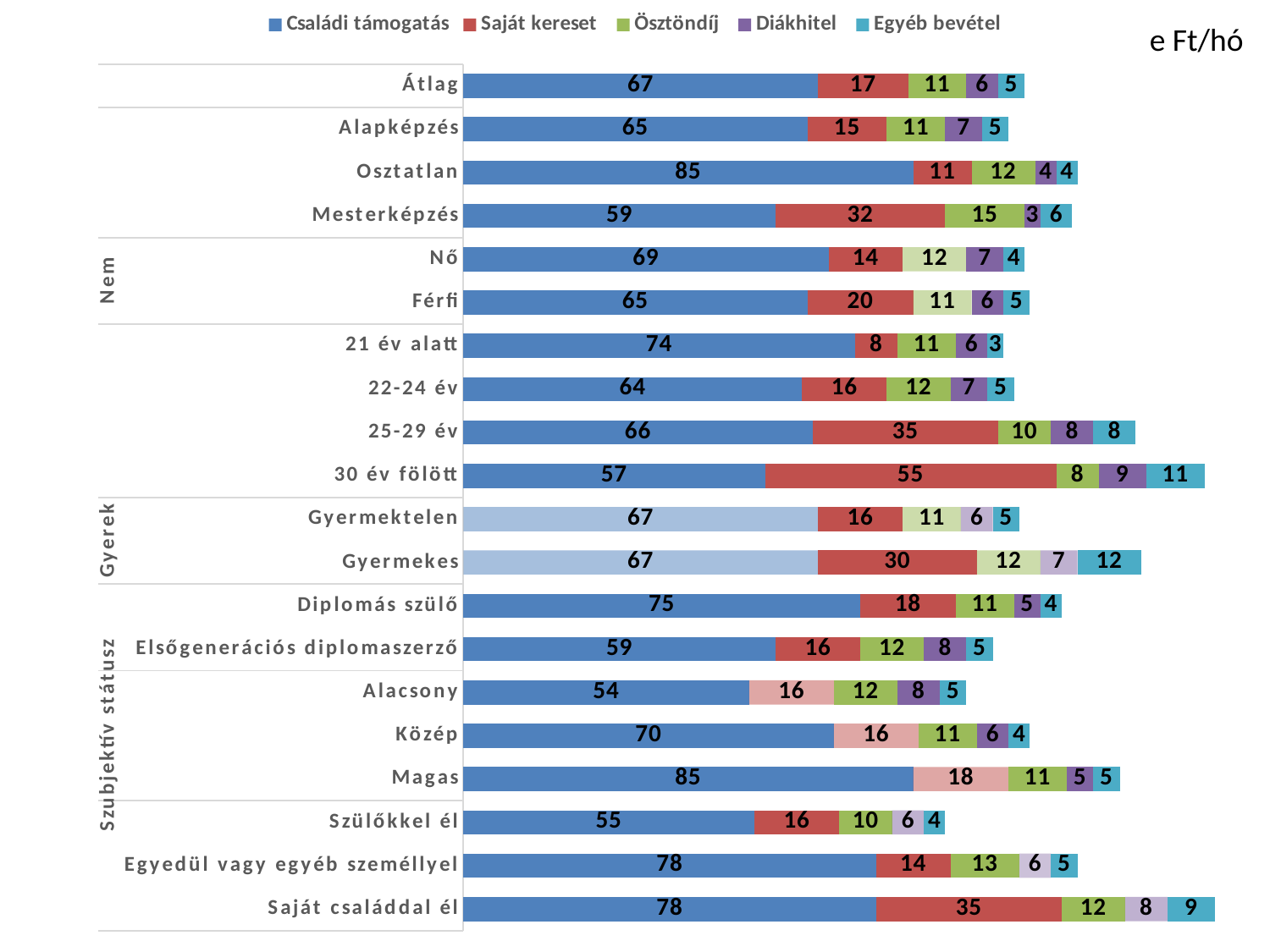
What is the total of the stacked bar for Átlag? 106 Which category has the lowest Családi támogatás value? Alacsony What is the difference between the Családi támogatás values for Osztatlan and Alapképzés? 20 What unit is shown in the top-right corner of the chart? e Ft/hó Which is larger, the Saját kereset value for 25-29 év or for 22-24 év? 25-29 év How many categories (bars) are plotted in the chart? 20 How many series does the legend list? 5 What is the Saját kereset value for 30 év fölött? 55 Which category has the highest Saját kereset value? 30 év fölött What is the Családi támogatás value for Mesterképzés? 59 What kind of chart is shown on the slide? stacked bar chart What is the Egyéb bevétel value for Gyermekes? 12